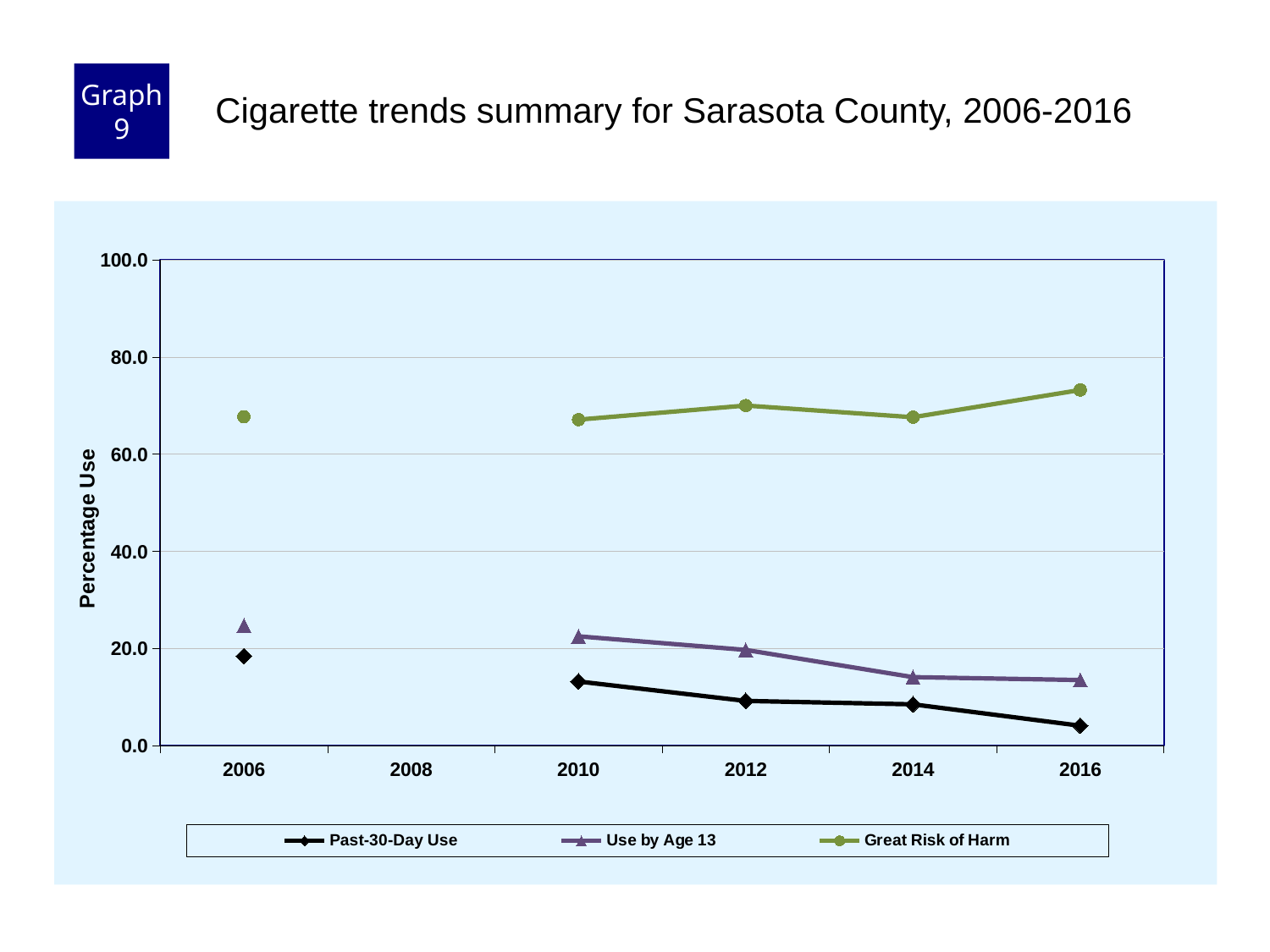
Is the value for Past-30-Day Use in 2016 greater or less than 20? less What kind of chart is shown on the slide? line chart In which year is the Use by Age 13 series at its highest? 2006 Is the value for Use by Age 13 in 2006 greater or less than 20? greater In which year is the Past-30-Day Use series at its lowest? 2016 Is the value for Great Risk of Harm in 2012 greater or less than 80? less What is the title of the vertical axis? Percentage Use How many series does the legend list? 3 Does the Past-30-Day Use series rise or fall from 2010 to 2016? fall How many years have data points plotted for the Past-30-Day Use series? 5 In 2016, which is larger: Use by Age 13 or Past-30-Day Use? Use by Age 13